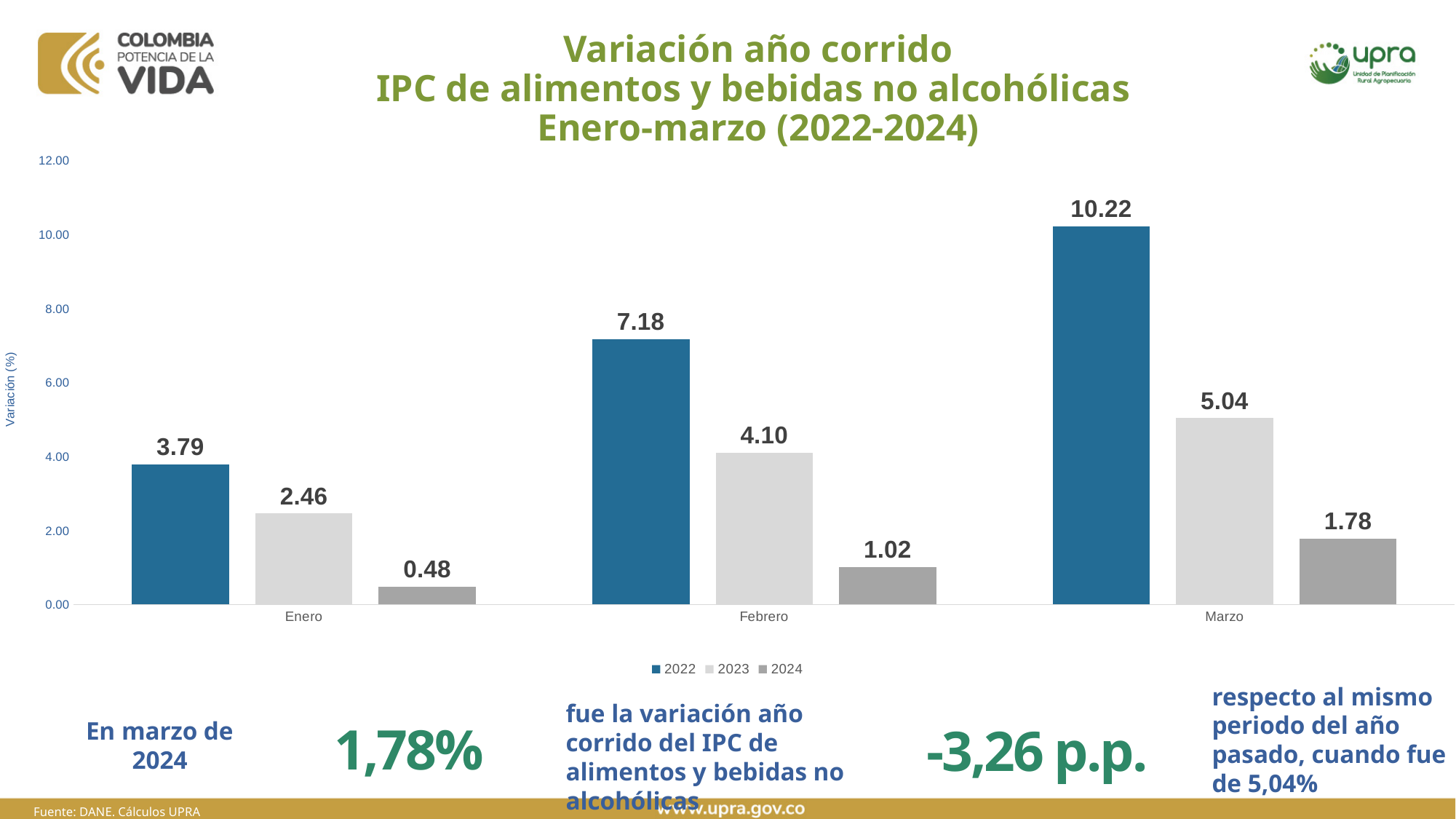
What kind of chart is shown on the slide? Bar chart How many months are shown on the x axis? 3 Which is larger in Enero: the 2022 value or the 2023 value? 2022 What is the value for 2024 in Enero? 0.48 What is the value for 2022 in Febrero? 7.18 What is the value for 2023 in Marzo? 5.04 How many series does the legend list? 3 Do the values for the 2024 series rise or fall from Enero to Marzo? Rise What is the difference between the 2023 and 2024 values in Marzo? 3.26 Which month has the lowest value for the 2024 series? Enero Is the value for 2022 in Marzo greater or less than 10.00? greater Which month has the highest value for the 2022 series? Marzo